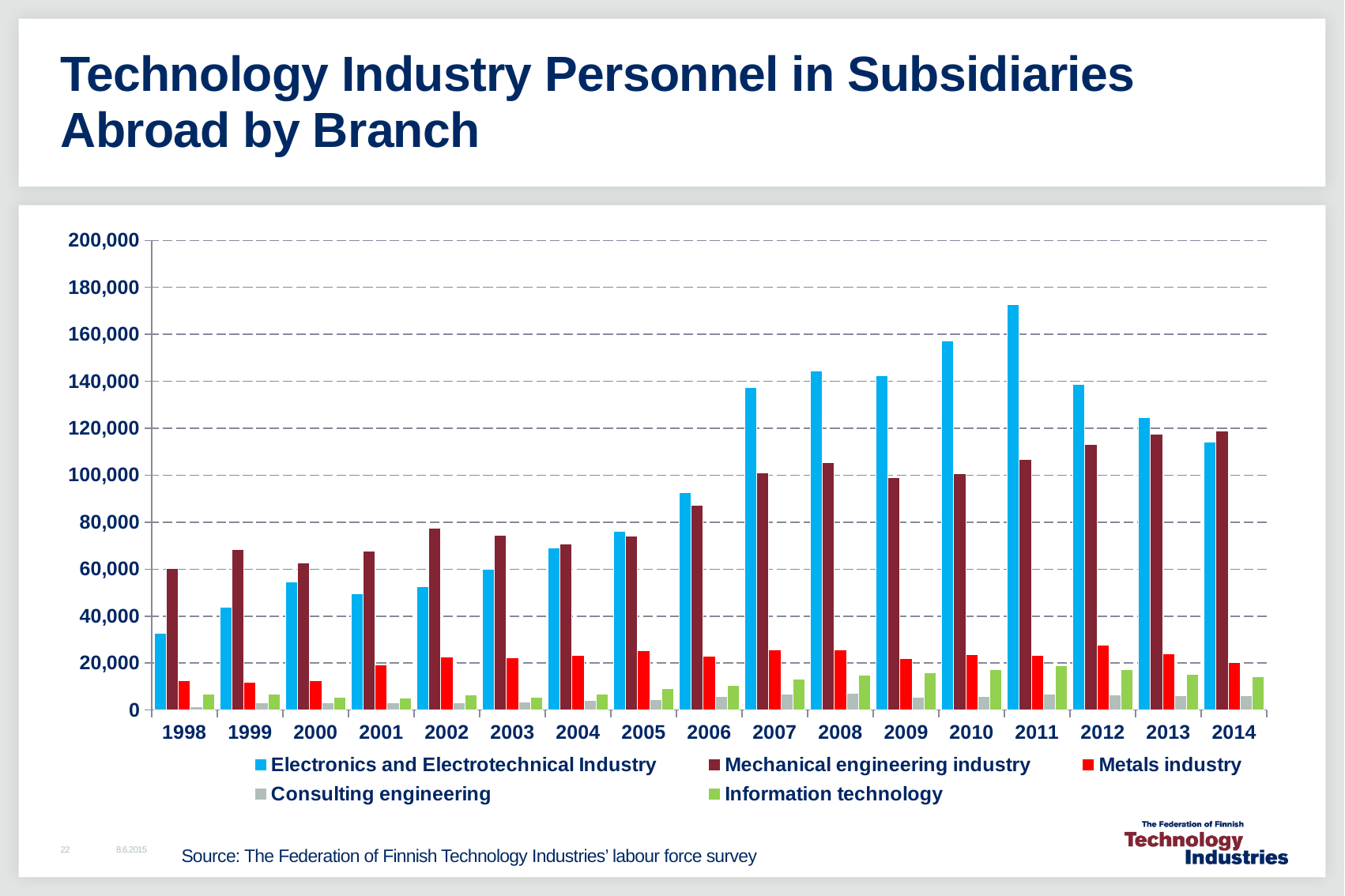
Is the value for Electronics and Electrotechnical Industry in 2011 greater or less than 160,000? greater Do the values for Electronics and Electrotechnical Industry rise or fall from 2011 to 2014? fall Is the value for Metals industry in 2012 greater or less than 20,000? greater What kind of chart is shown on the slide? bar chart What colour represents the Metals industry series? red In which year is the value for Electronics and Electrotechnical Industry lowest? 1998 Is the value for Mechanical engineering industry in 1998 greater or less than 80,000? less In 2010, which is larger: Electronics and Electrotechnical Industry or Mechanical engineering industry? Electronics and Electrotechnical Industry How many series does the legend list? 5 How many years are shown on the x axis? 17 In 1998, which is larger: Electronics and Electrotechnical Industry or Mechanical engineering industry? Mechanical engineering industry In which year is the value for Electronics and Electrotechnical Industry highest? 2011